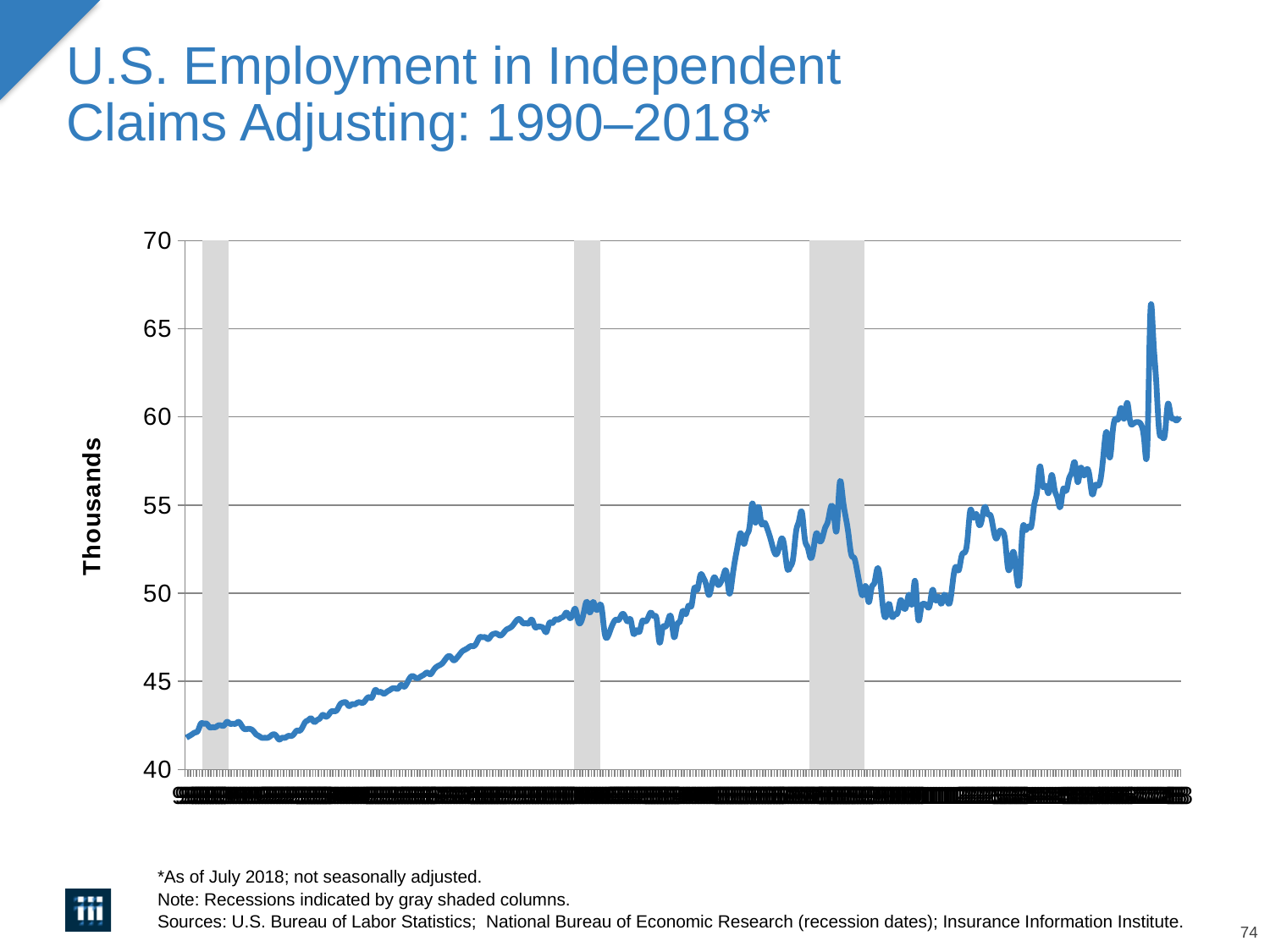
Is the value at the end of the series greater or less than 65? less What kind of chart is shown on the slide? line chart How many gray shaded recession columns appear on the chart? 3 Is the highest point on the line greater or less than 65? greater Is the lowest point on the line greater or less than 45? less How many lines (series) are plotted on the chart? 1 Which is larger, the value at the start of the series or the value at the end of the series? the value at the end of the series What is the title of the vertical axis? Thousands Overall, do the values rise or fall from the left of the chart to the right? rise